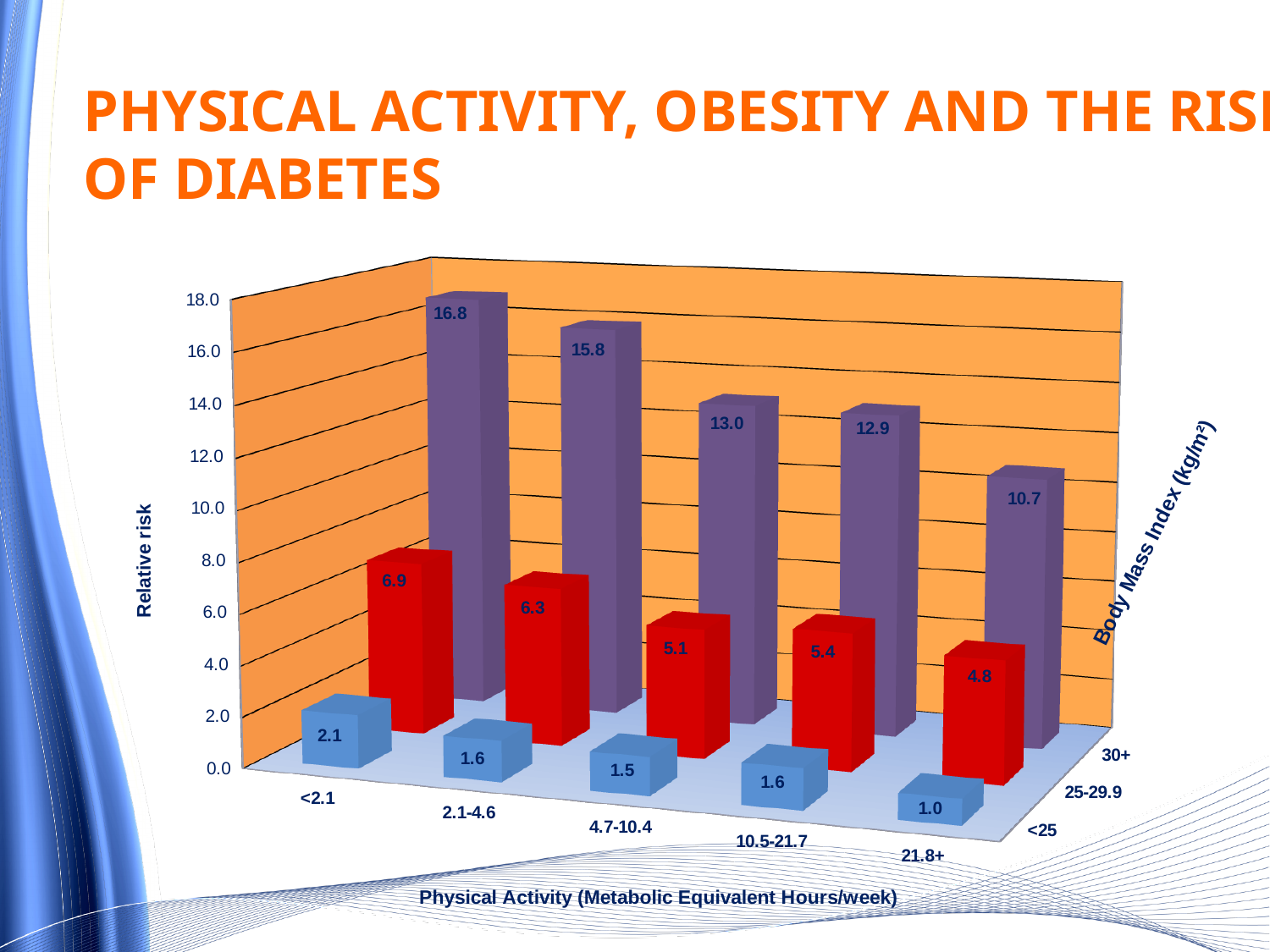
What is the relative risk for the <25 BMI group at physical activity 21.8+ MET hours/week? 1.0 Which is larger: the relative risk for the 25-29.9 BMI group at 2.1-4.6 MET hours/week or at 10.5-21.7 MET hours/week? 2.1-4.6 How many physical activity categories are shown on the x axis? 5 What is the label of the vertical axis of the chart? Relative risk What is the relative risk for the 30+ BMI group at physical activity <2.1 MET hours/week? 16.8 Does the relative risk for the 30+ BMI group rise or fall as physical activity increases from <2.1 to 21.8+ MET hours/week? Fall What kind of chart is shown on the slide? Bar chart Which physical activity category has the highest relative risk for the 30+ BMI group? <2.1 Which physical activity category has the lowest relative risk for the <25 BMI group? 21.8+ What is the relative risk for the 25-29.9 BMI group at physical activity 4.7-10.4 MET hours/week? 5.1 How many Body Mass Index groups are plotted in the chart? 3 What is the difference in relative risk between the 30+ and <25 BMI groups at physical activity <2.1 MET hours/week? 14.7